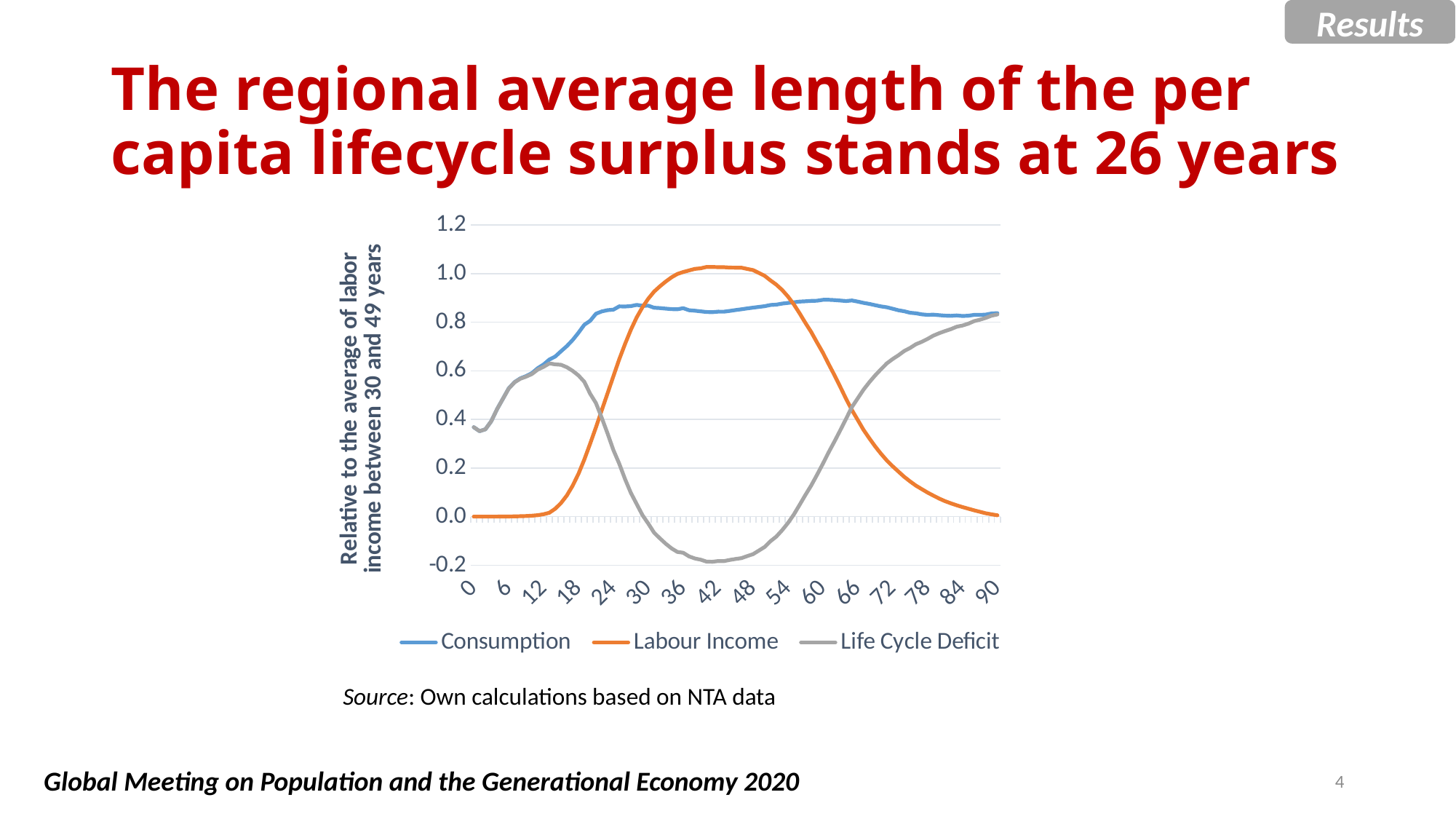
What is the title of the vertical axis? Relative to the average of labor income between 30 and 49 years How many series does the legend list? 3 What kind of chart is shown on the slide? line chart Which series reaches the highest value on the chart? Labour Income Is the value of Life Cycle Deficit at age 42 greater or less than 0.0? less Is the value of Life Cycle Deficit at age 90 greater or less than 0.6? greater What are the three series named in the legend? Consumption, Labour Income, Life Cycle Deficit Does the Labour Income line rise or fall between age 48 and age 90? fall Is the value of Labour Income at age 42 greater or less than 0.8? greater At age 42, which is higher: Consumption or Labour Income? Labour Income At age 12, which is higher: Consumption or Labour Income? Consumption